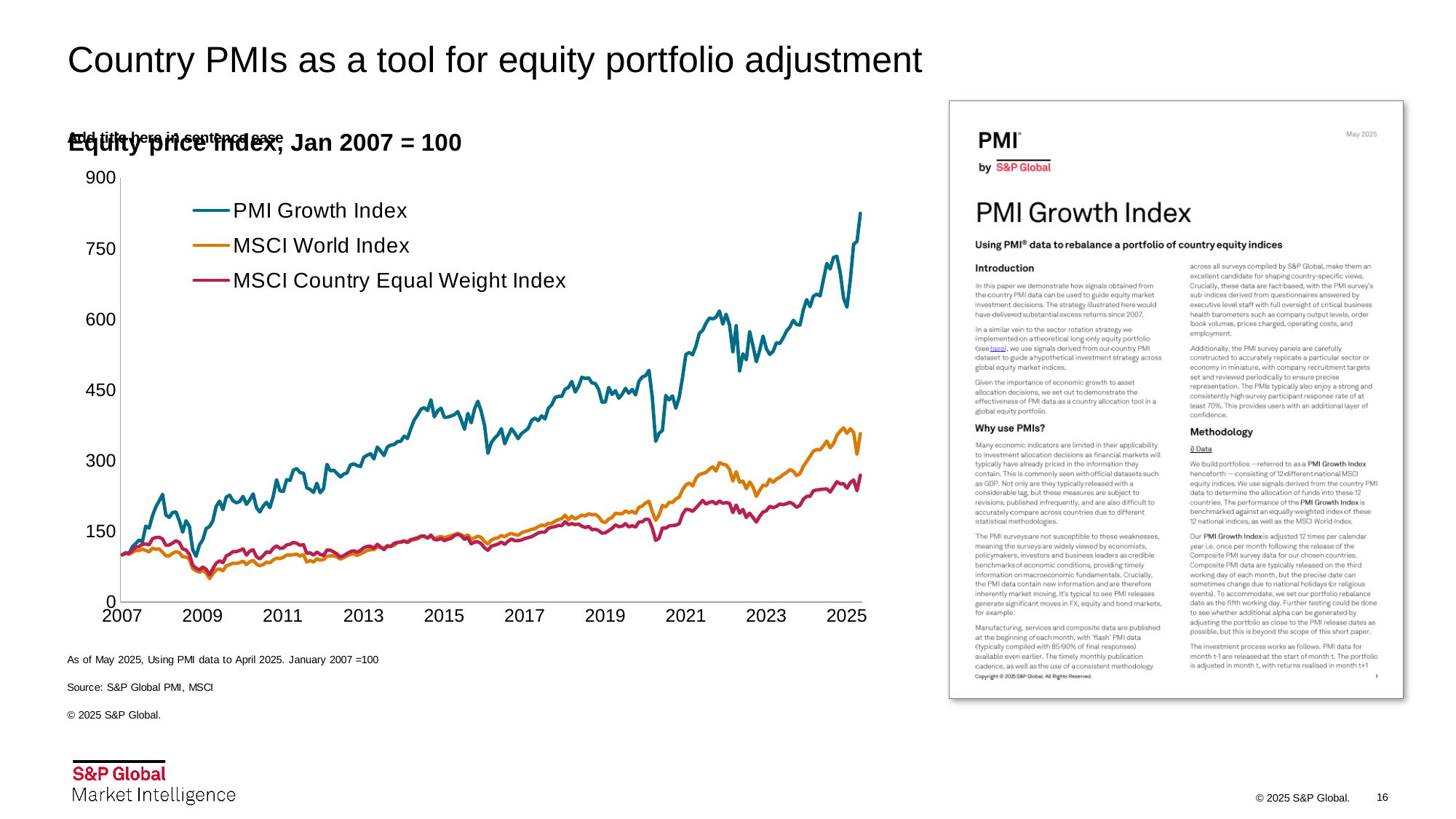
Does the PMI Growth Index generally rise or fall from 2007 to 2025? Rise What is the base value of the equity price index in January 2007, according to the chart title? 100 Is the value of the PMI Growth Index in 2019 greater or less than 300? greater What kind of chart is shown on the slide? Line chart Which series are listed in the chart legend? PMI Growth Index, MSCI World Index, MSCI Country Equal Weight Index Which is larger in 2021: the PMI Growth Index or the MSCI World Index? PMI Growth Index Which series has the highest value at the end of the chart in 2025? PMI Growth Index How many series does the chart legend list? 3 Is the value of the MSCI Country Equal Weight Index at the end of the chart in 2025 greater or less than 300? less Is the value of the PMI Growth Index at the end of the chart in 2025 greater or less than 750? greater Which series has the lowest value at the end of the chart in 2025? MSCI Country Equal Weight Index